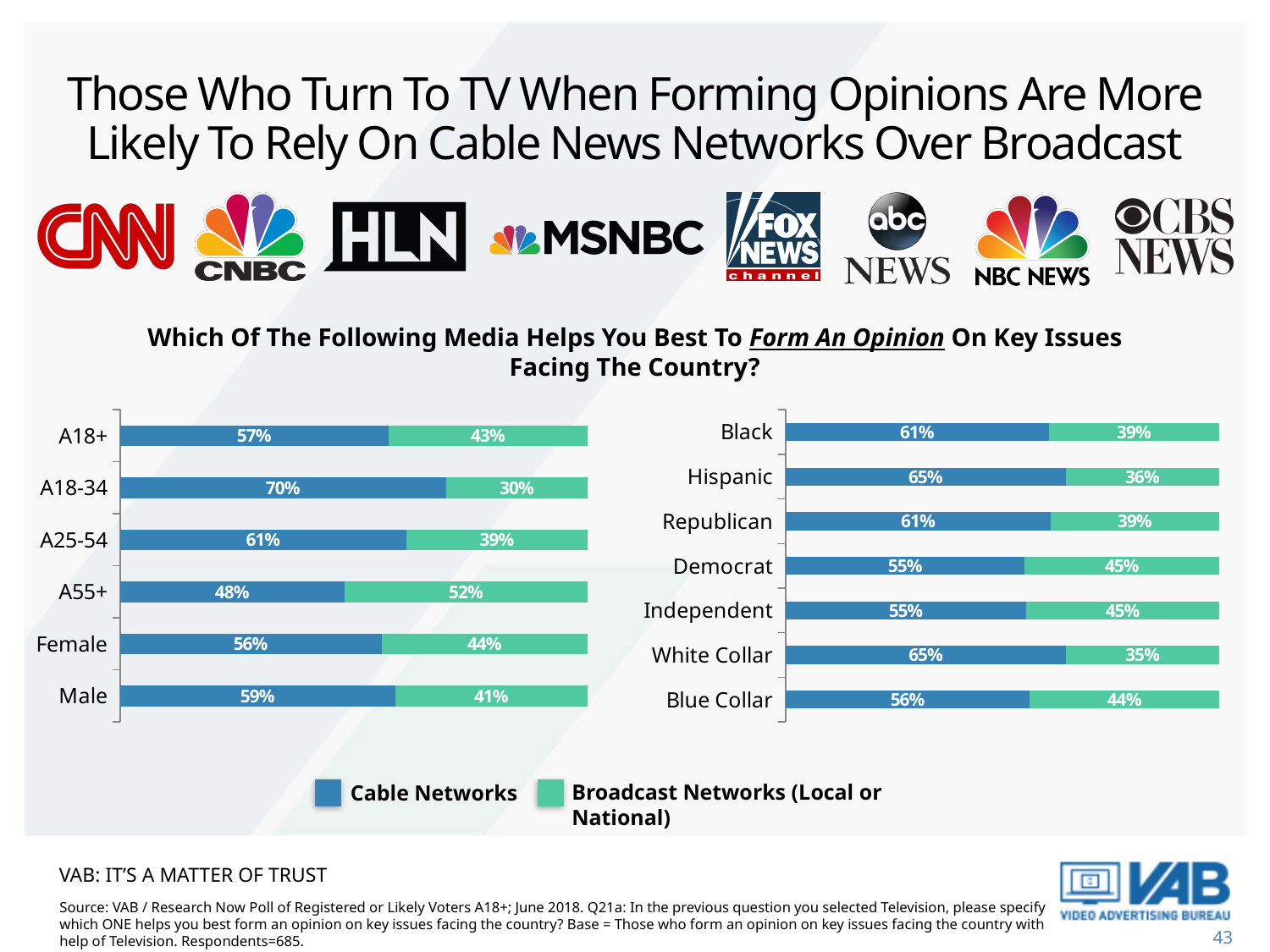
What kind of chart is used on the left side of the slide? Stacked bar chart On the left chart, how many categories are shown? 6 On the left chart, which category has the highest Cable Networks value? A18-34 On the left chart, which category has the lowest Cable Networks value? A55+ On the right chart, what is the total of the stacked bar for Blue Collar? 100% On the right chart, what is the Broadcast Networks (Local or National) value for White Collar? 35% On the left chart, what is the Cable Networks value for A18-34? 70% On the left chart, what is the difference between the Cable Networks values for Male and Female? 3% On the right chart, which is larger: the Cable Networks value for Hispanic or for Democrat? Hispanic On the right chart, which category has the highest Broadcast Networks (Local or National) value? Democrat and Independent (45%) How many series does the legend list? 2 On the right chart, how many categories are shown? 7